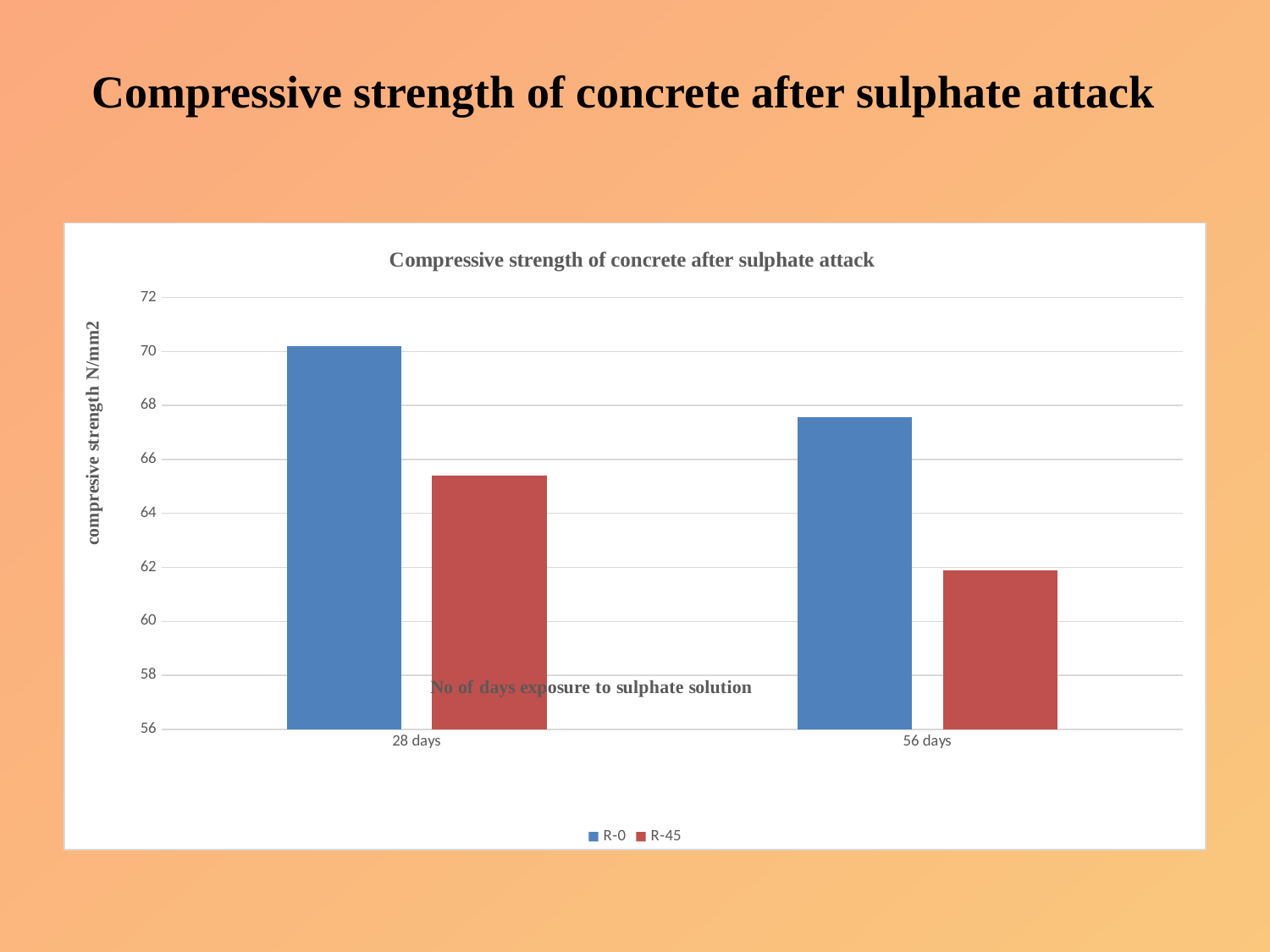
What is the label of the y axis? compresive strength N/mm2 What kind of chart is shown on the slide? bar chart Does the compressive strength of R-45 rise or fall from 28 days to 56 days? fall Is the value for R-0 at 56 days greater or less than 68? less Which series and category has the lowest compressive strength? R-45 at 56 days Which series and category has the highest compressive strength? R-0 at 28 days Which is larger at 56 days, R-0 or R-45? R-0 Is the value for R-45 at 28 days greater or less than 66? less How many series does the legend list? 2 How many categories are shown on the x axis? 2